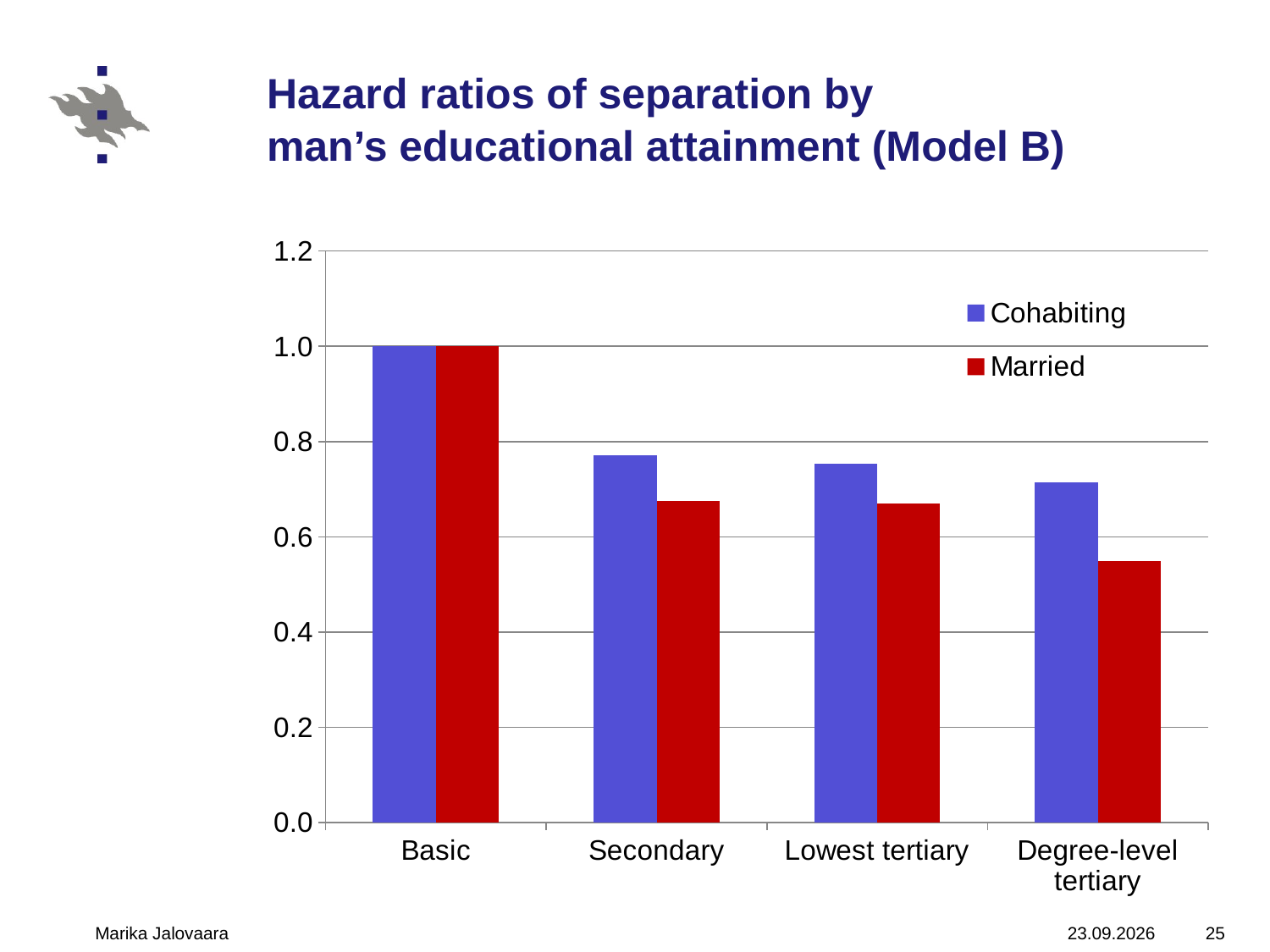
In the Degree-level tertiary category, which is larger: the Cohabiting value or the Married value? Cohabiting What kind of chart is shown on the slide? bar chart Is the Married value for Degree-level tertiary greater or less than 0.6? less Is the Cohabiting value for Secondary greater or less than 0.8? less What is the hazard ratio for Cohabiting in the Basic category? 1.0 How many series does the legend list? 2 Which category has the highest hazard ratio for the Married series? Basic Is the Married value for Secondary greater or less than 0.6? greater How many educational attainment categories are shown on the x axis? 4 Do the Married hazard ratios rise or fall from Basic to Degree-level tertiary? fall Which category has the lowest hazard ratio for the Married series? Degree-level tertiary What is the hazard ratio for Married in the Basic category? 1.0